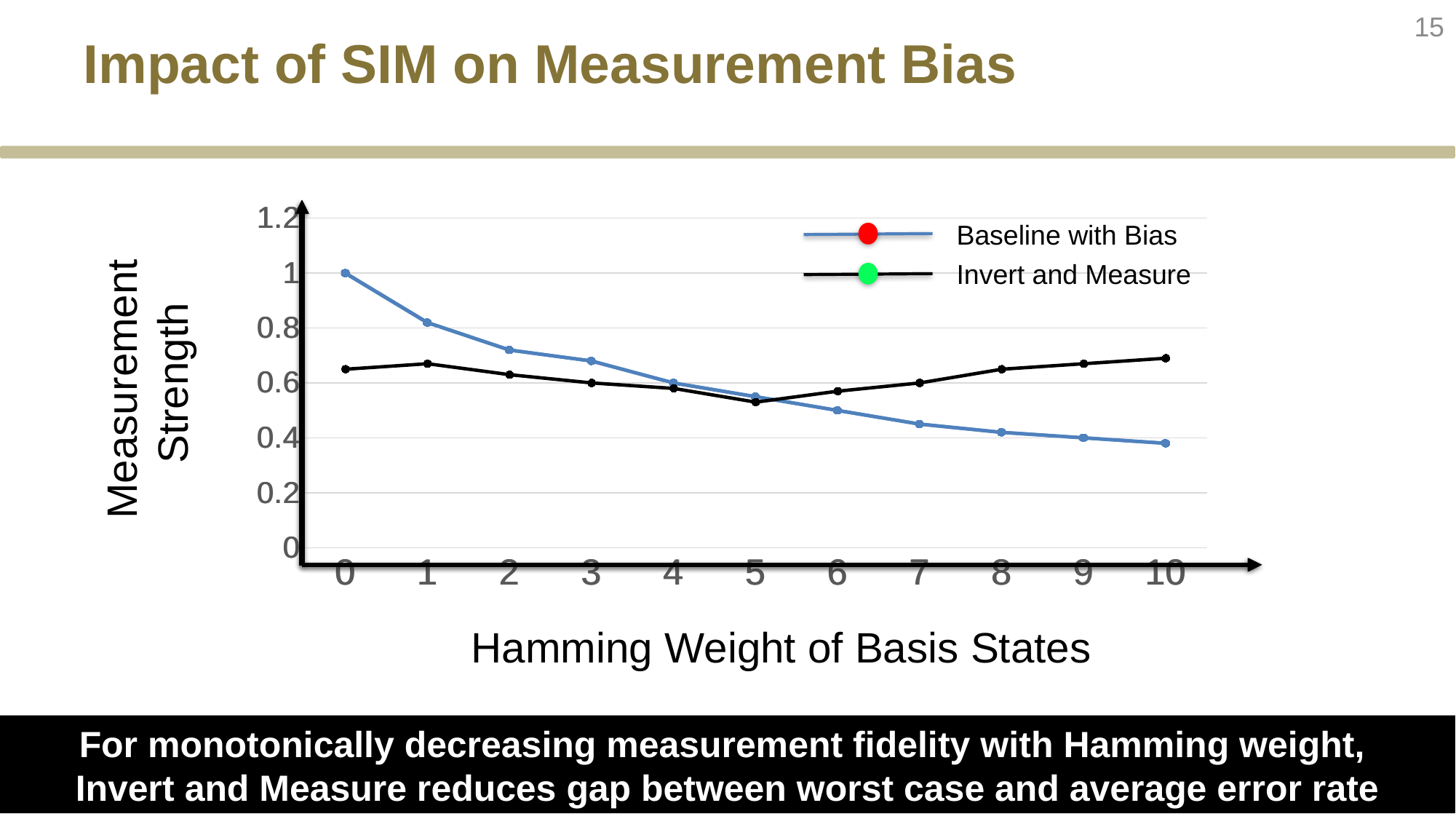
At Hamming weight 10, which series has the larger Measurement Strength, Baseline with Bias or Invert and Measure? Invert and Measure How many Hamming weight values are plotted along the x axis? 11 How many series does the legend list? 2 Is the value for Invert and Measure at Hamming weight 10 greater or less than 0.6? greater What is the Measurement Strength of Baseline with Bias at Hamming weight 0? 1 Does Baseline with Bias rise or fall as Hamming weight increases? fall At which Hamming weight is Baseline with Bias highest? 0 At which Hamming weight is Invert and Measure lowest? 5 At which Hamming weight is Baseline with Bias lowest? 10 What is the title of the x axis? Hamming Weight of Basis States What kind of chart is shown on the slide? line chart